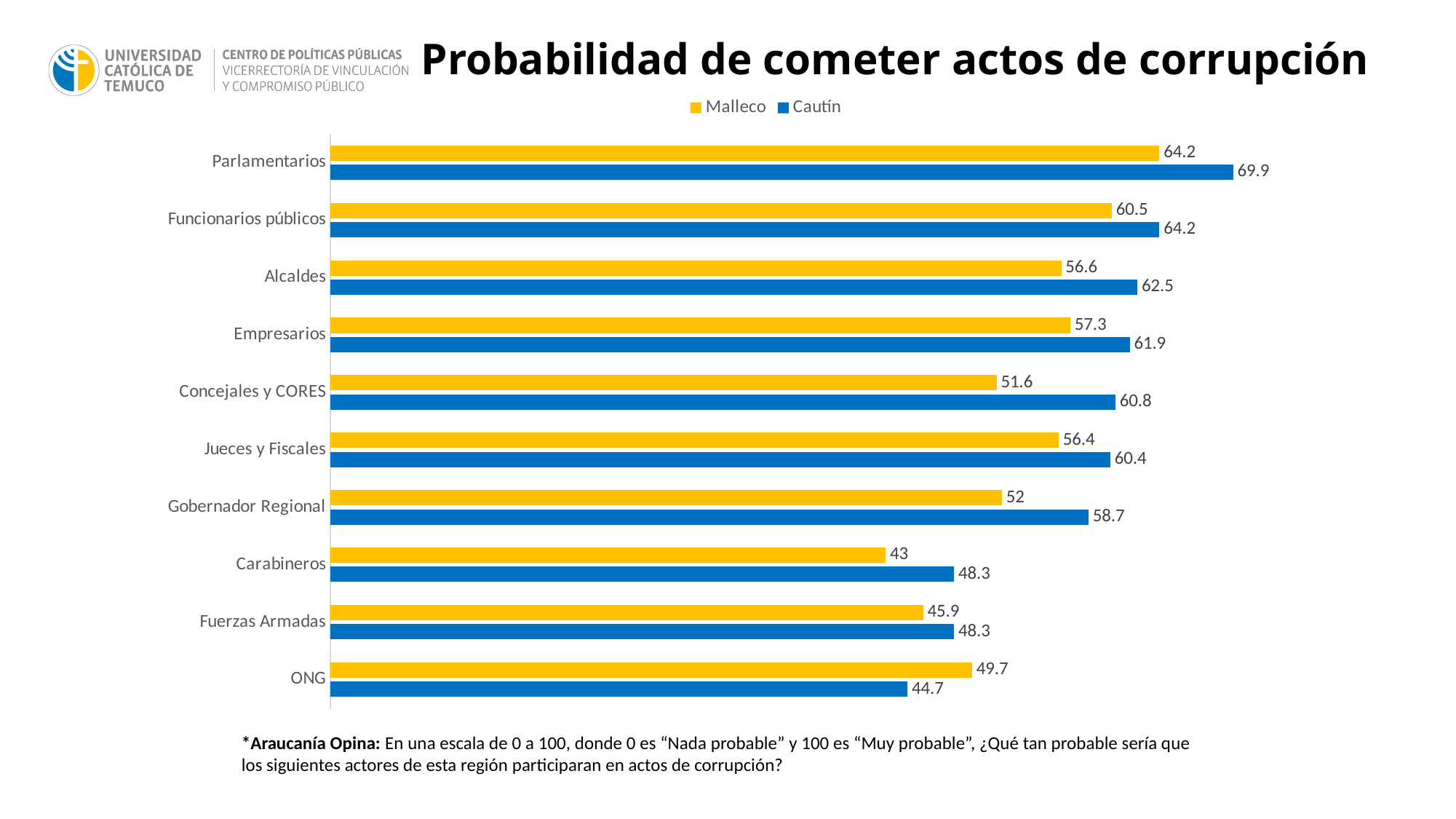
What is the Malleco value for Carabineros? 43 What is the Cautín value for Concejales y CORES? 60.8 What kind of chart is shown on the slide? Bar chart How many categories are shown on the chart? 10 What is the difference between the Cautín and Malleco values for Gobernador Regional? 6.7 How many series does the legend list? 2 Which category has the lowest Malleco value? Carabineros What is the title of the chart? Probabilidad de cometer actos de corrupción What is the Malleco value for Parlamentarios? 64.2 Which category has the highest Cautín value? Parlamentarios Which colour represents the Cautín series? Blue For ONG, which series has the larger value, Malleco or Cautín? Malleco